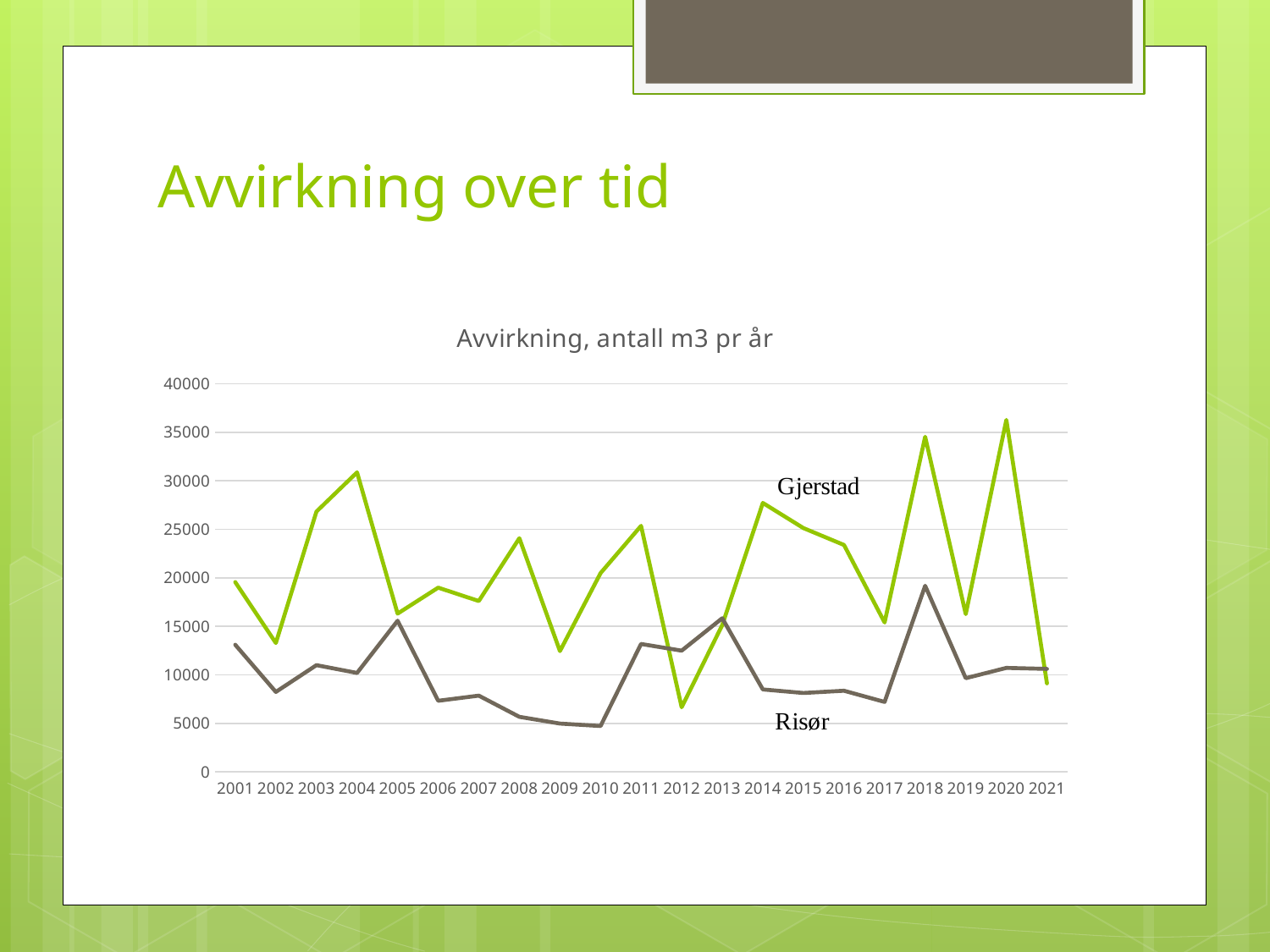
Is the value for Gjerstad in 2020 greater or less than 35000? greater In which year does the Gjerstad series reach its highest value? 2020 What kind of chart is shown on the slide? line chart How many series are plotted on the chart? 2 What is the title of the chart? Avvirkning, antall m3 pr år Is the value for Risør in 2018 greater or less than 15000? greater In 2001, which series has the larger value, Gjerstad or Risør? Gjerstad Is the value for Gjerstad in 2012 greater or less than 10000? less In which year does the Gjerstad series reach its lowest value? 2012 Which colour is used for the Gjerstad line? green How many years are shown along the x axis? 21 In which year does the Risør series reach its highest value? 2018